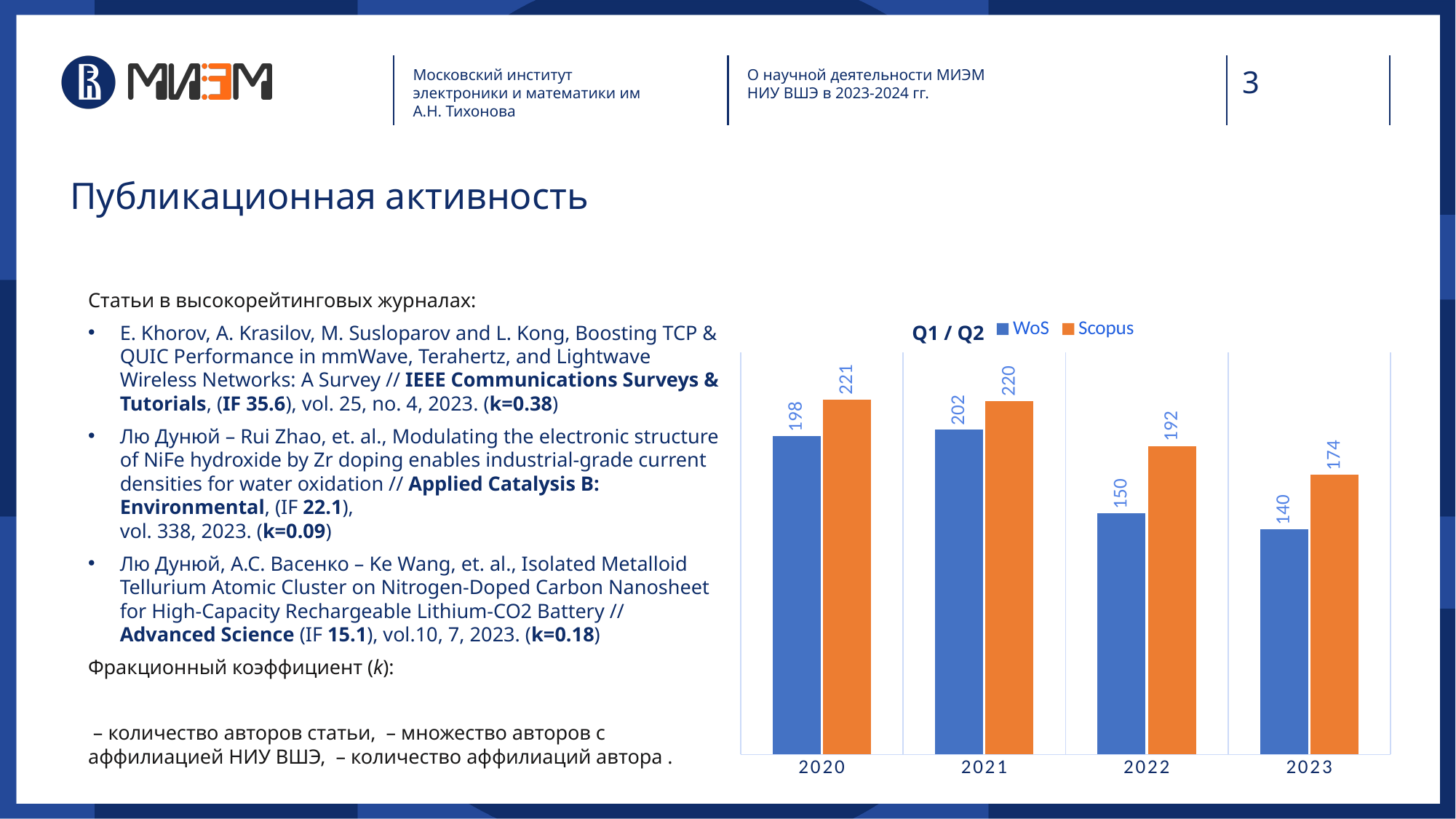
Which is larger in 2021, the WoS value or the Scopus value? Scopus Which year has the highest Scopus value? 2020 What is the Scopus value for 2023? 174 Which year has the lowest WoS value? 2023 What is the difference between the WoS values for 2021 and 2023? 62 How many series does the legend list? 2 What is the difference between the Scopus and WoS values for 2022? 42 Do the WoS values rise or fall from 2021 to 2023? fall What is the Scopus value for 2022? 192 What is the WoS value for 2020? 198 What kind of chart is shown on the slide? bar chart How many years are shown on the x axis? 4